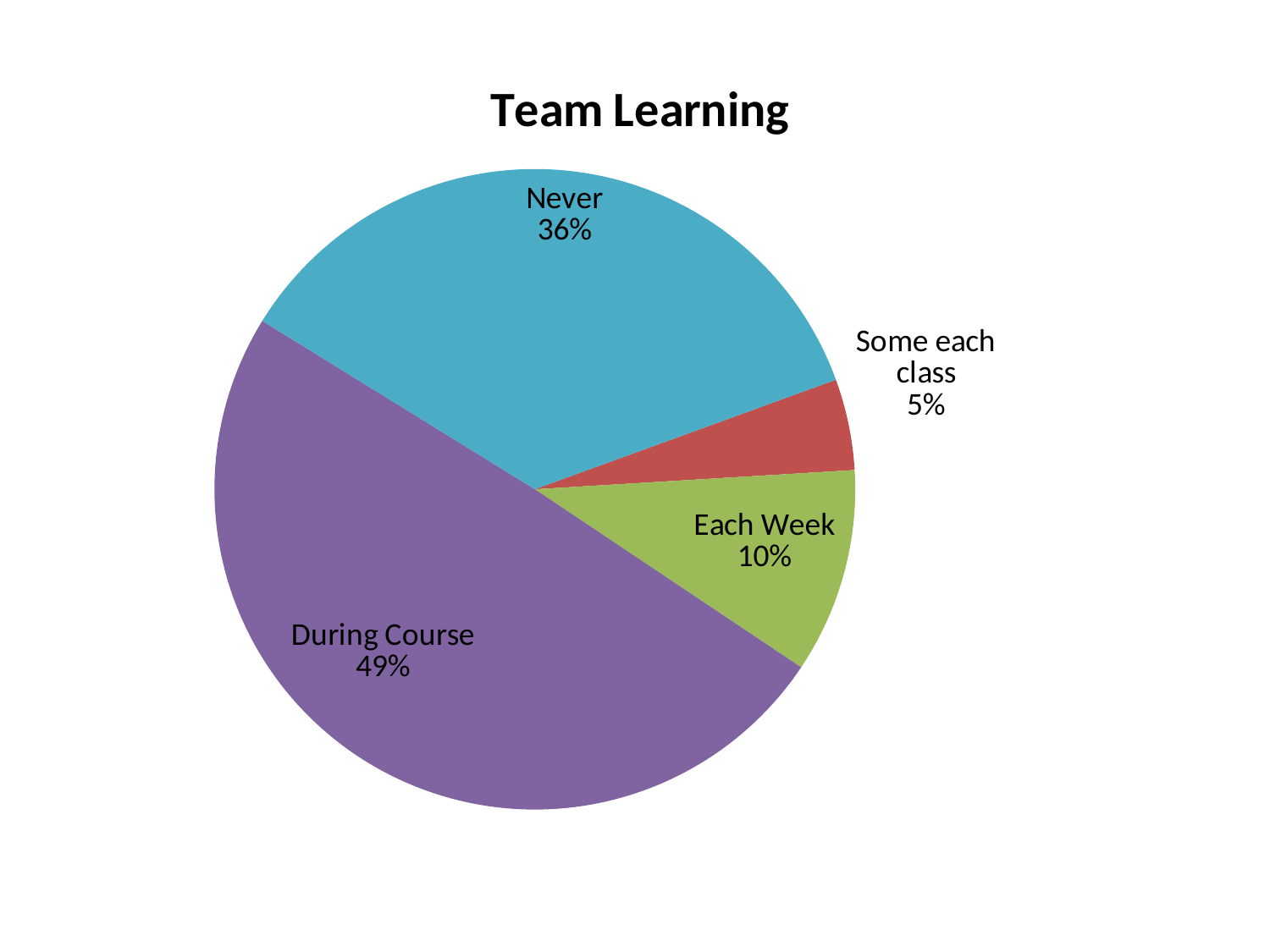
What colour is the "During Course" slice? purple What percentage of the pie is labelled "Each Week"? 10% How many slices does the pie chart have? 4 What percentage of the pie is labelled "During Course"? 49% What percentage of the pie is labelled "Never"? 36% What percentage of the pie is labelled "Some each class"? 5% What kind of chart is shown on the slide? pie chart Which slice of the pie is the largest? During Course Which slice is larger, "Each Week" or "Some each class"? Each Week What is the difference in percentage points between the "During Course" slice and the "Never" slice? 13 Which slice of the pie is the smallest? Some each class What is the title of the chart? Team Learning